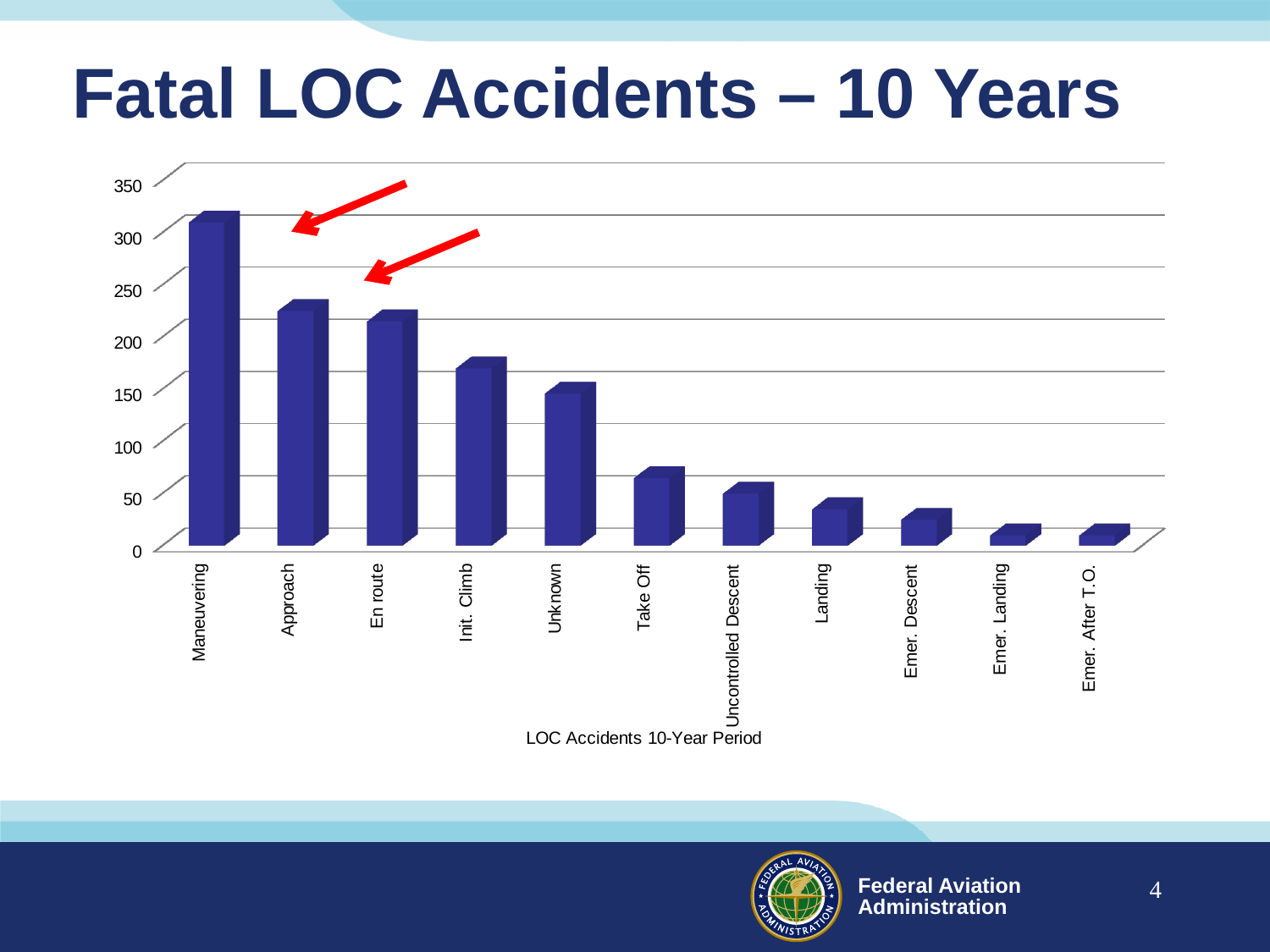
Do the values rise or fall moving from left to right along the x axis? Fall Which is larger, the value for Maneuvering or the value for Approach? Maneuvering What is the label printed beneath the x axis of the chart? LOC Accidents 10-Year Period What kind of chart is shown on the slide? Bar chart Is the value for Landing greater or less than 50? less Is the value for Approach greater or less than 200? greater Is the value for Maneuvering greater or less than 250? greater Which is larger, the value for Init. Climb or the value for Unknown? Init. Climb Which category has the highest number of fatal LOC accidents? Maneuvering How many categories are plotted along the x axis? 11